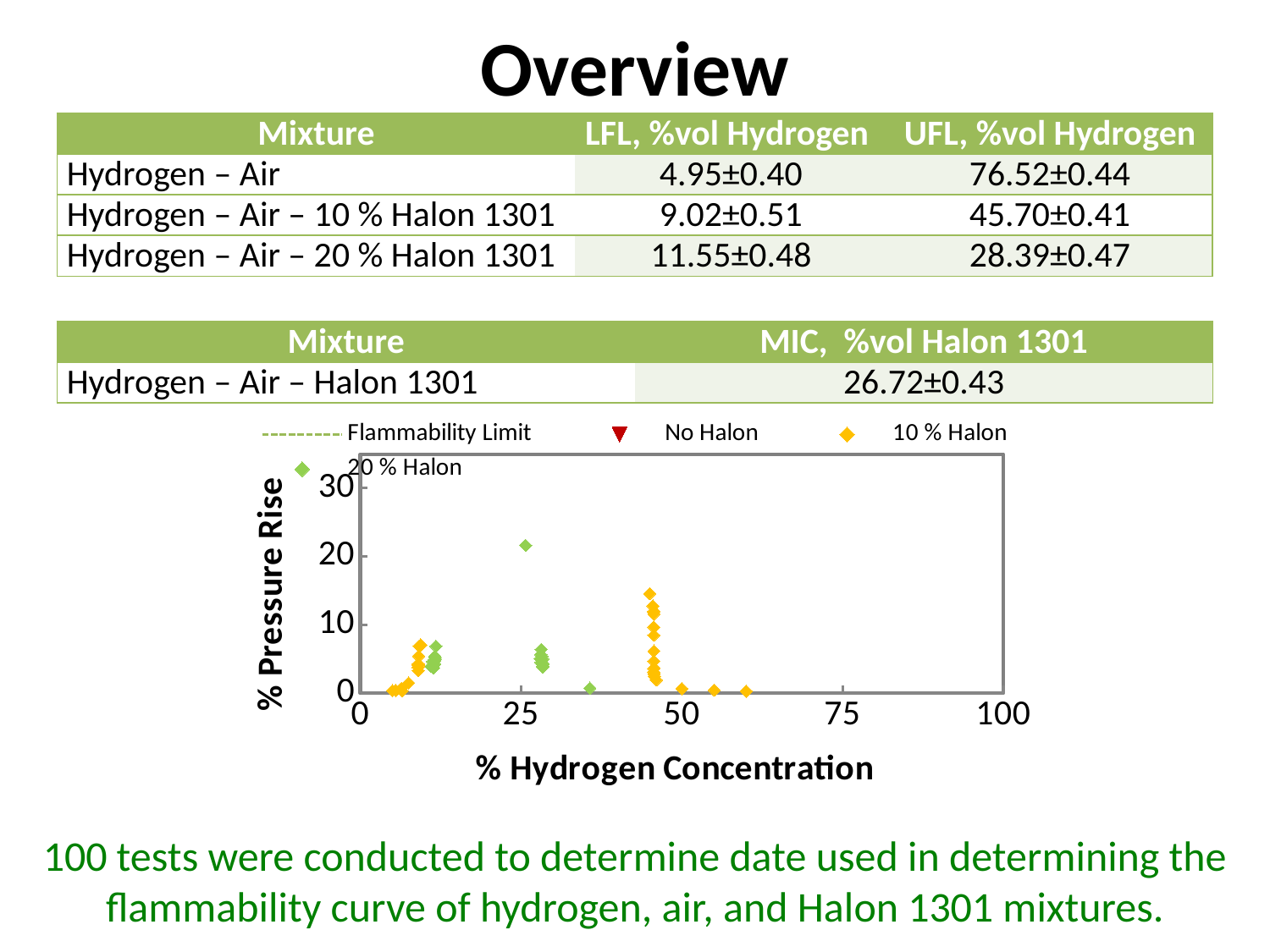
Is the highest % Pressure Rise reached by the 10 % Halon series greater or less than 20? less What is the title of the x axis of the chart? % Hydrogen Concentration What kind of chart is shown on the slide? scatter chart What is the maximum value shown on the y axis of the chart? 30 How many series does the chart legend list? 4 Which series reaches a higher % Pressure Rise on the chart, 10 % Halon or 20 % Halon? 20 % Halon Is the highest % Pressure Rise reached by the 20 % Halon series greater or less than 10? greater Is the largest % Hydrogen Concentration at which a 10 % Halon point is plotted greater or less than 75? less What is the maximum value shown on the x axis of the chart? 100 What is the title of the y axis of the chart? % Pressure Rise